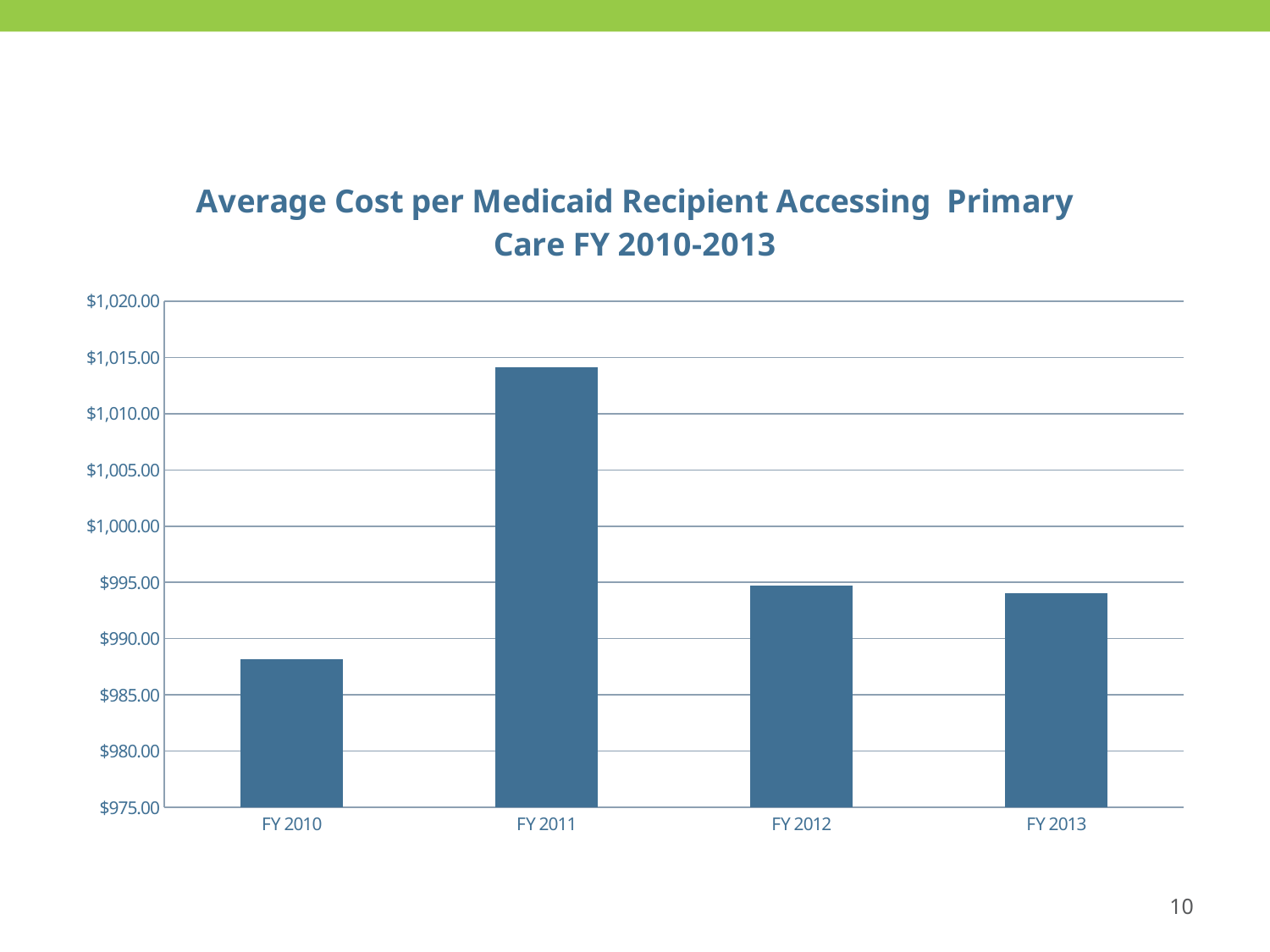
Is the value for FY 2010 greater or less than $985.00? greater Which is larger, the value for FY 2010 or the value for FY 2013? FY 2013 What kind of chart is shown on the slide? bar chart Is the value for FY 2012 greater or less than $990.00? greater What is the title of the chart? Average Cost per Medicaid Recipient Accessing Primary Care FY 2010-2013 How many fiscal years are plotted on the chart? 4 Which fiscal year has the lowest average cost per Medicaid recipient? FY 2010 Is the value for FY 2013 greater or less than $1,000.00? less Which fiscal year has the highest average cost per Medicaid recipient? FY 2011 Which is larger, the value for FY 2011 or the value for FY 2012? FY 2011